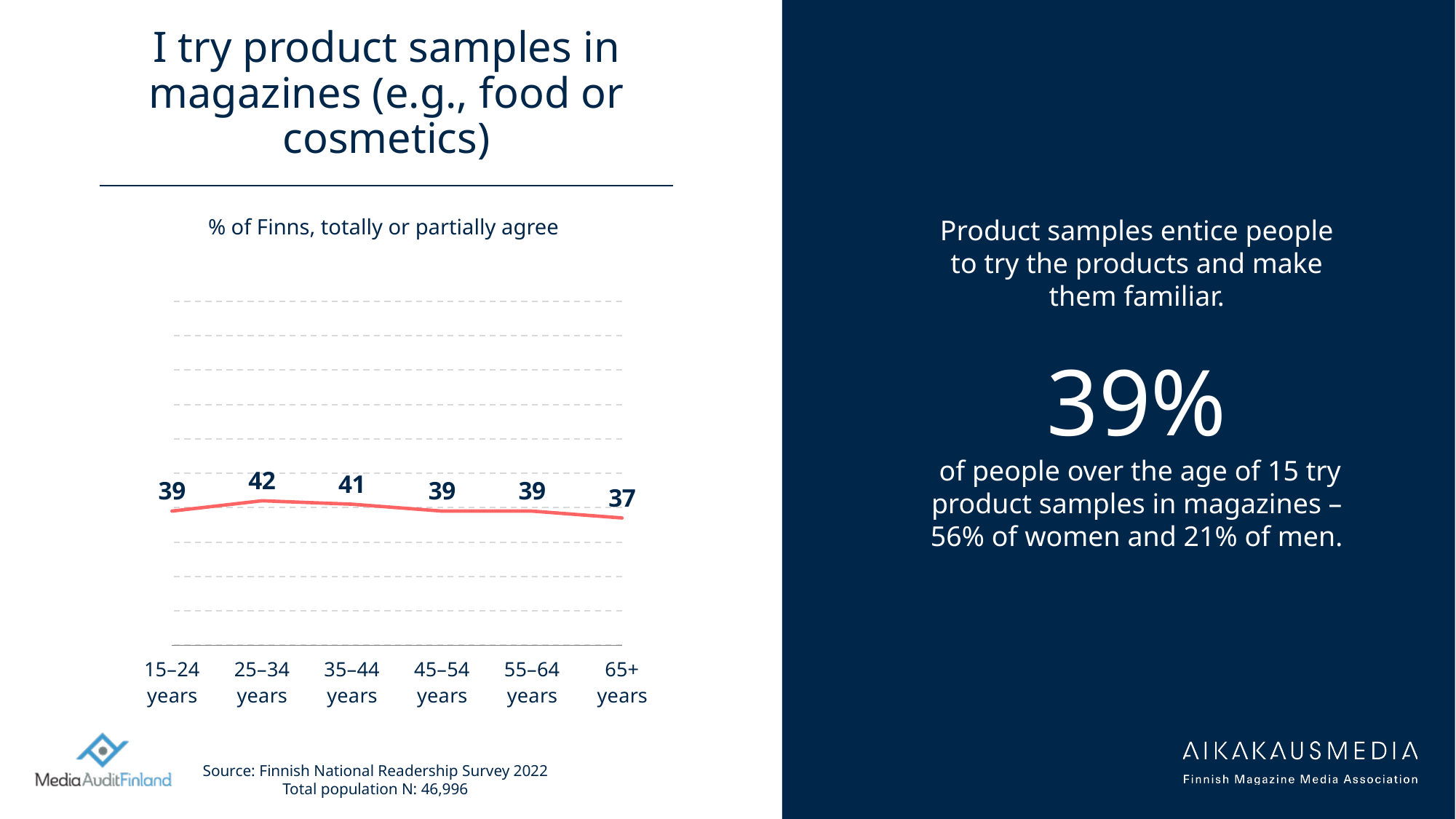
What is the difference between the values for 25–34 years and 65+ years? 5 Which is larger, the value for 35–44 years or the value for 45–54 years? 35–44 years What is the value for 25–34 years? 42 What is the difference between the values for 15–24 years and 25–34 years? 3 How many age groups are plotted on the chart? 6 Which age group has the highest value? 25–34 years What is the subtitle shown above the chart? % of Finns, totally or partially agree What kind of chart is shown on the slide? line chart Which age group has the lowest value? 65+ years What is the value for 35–44 years? 41 What is the value for 65+ years? 37 Do the values rise or fall from 35–44 years to 65+ years? fall